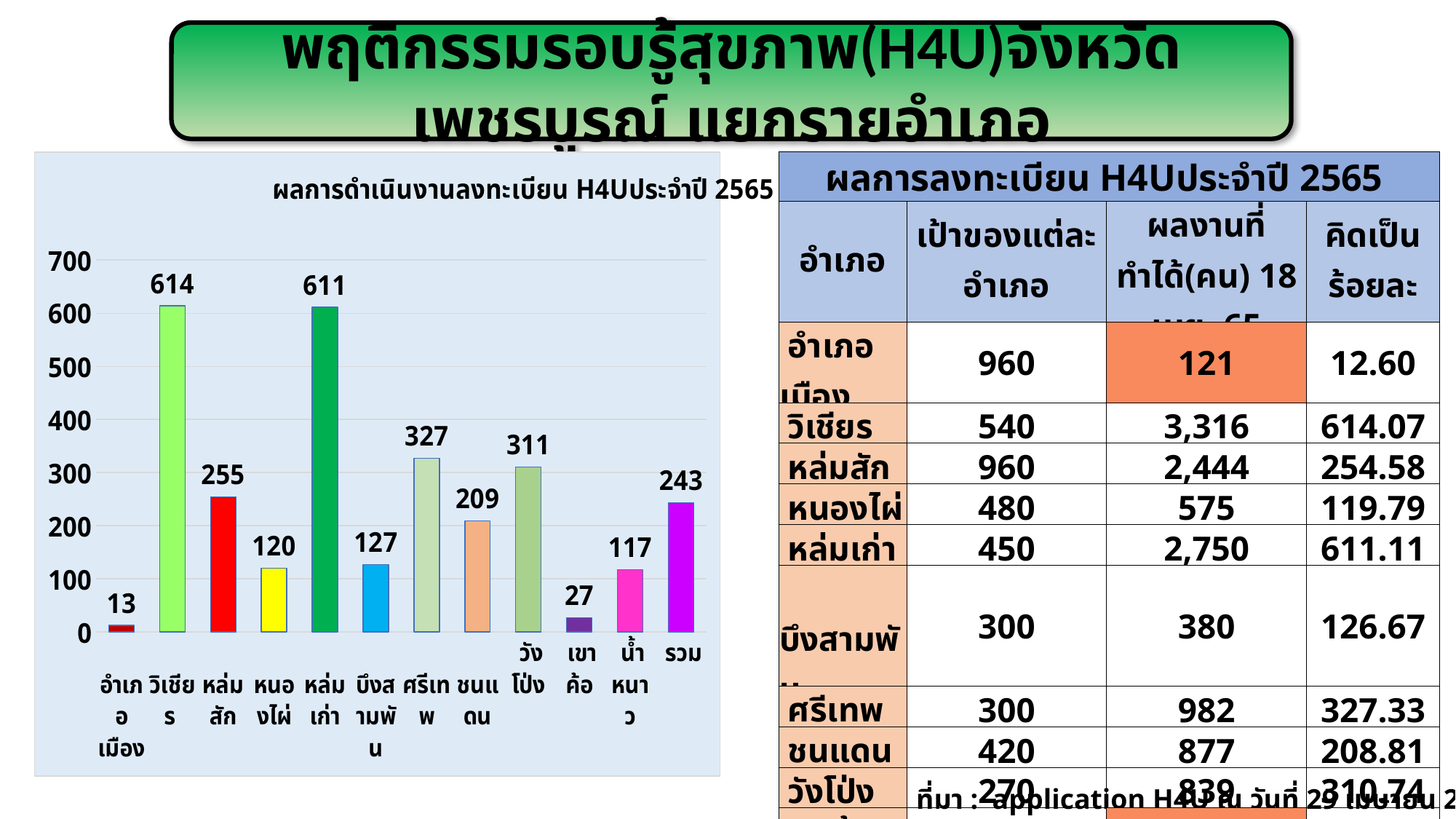
What is the value for วิเชียร in the chart? 614 What is the value for ศรีเทพ in the chart? 327 What is the title of the chart? ผลการดำเนินงานลงทะเบียน H4Uประจำปี 2565 How many categories are plotted on the x axis of the chart? 12 Is the value for หล่มสัก greater or less than 200? greater What is the difference between the values for ศรีเทพ and ชนแดน? 118 Which is larger, the value for วังโป่ง or the value for ศรีเทพ? ศรีเทพ What type of chart is shown on the slide? bar chart Which category has the lowest value in the chart? อำเภอเมือง Which category has the highest value in the chart? วิเชียร What is the value for เขาค้อ in the chart? 27 What is the value for รวม in the chart? 243